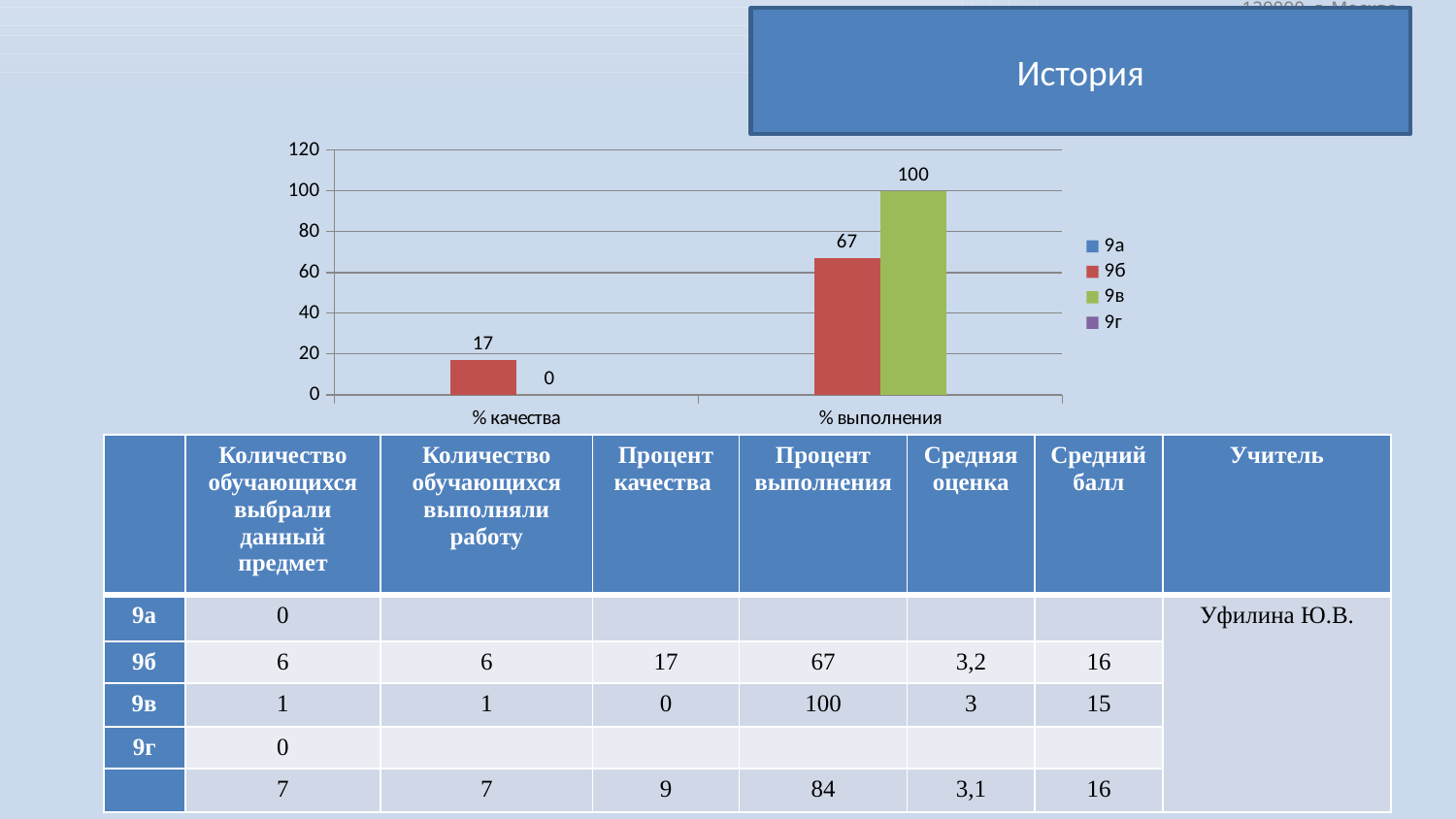
What is the value for 9в in the % качества category? 0 Which series has the highest value in the % выполнения category? 9в Is the value for 9б in % выполнения greater or less than 60? greater What is the value for 9б in the % выполнения category? 67 How many series does the legend list? 4 How many categories are shown on the x axis? 2 What is the value for 9в in the % выполнения category? 100 What is the difference between the 9в and 9б values in the % выполнения category? 33 What is the value for 9б in the % качества category? 17 What kind of chart is shown on the slide? bar chart What is the difference between the 9б values for % выполнения and % качества? 50 Which is larger for 9б: the % качества value or the % выполнения value? % выполнения